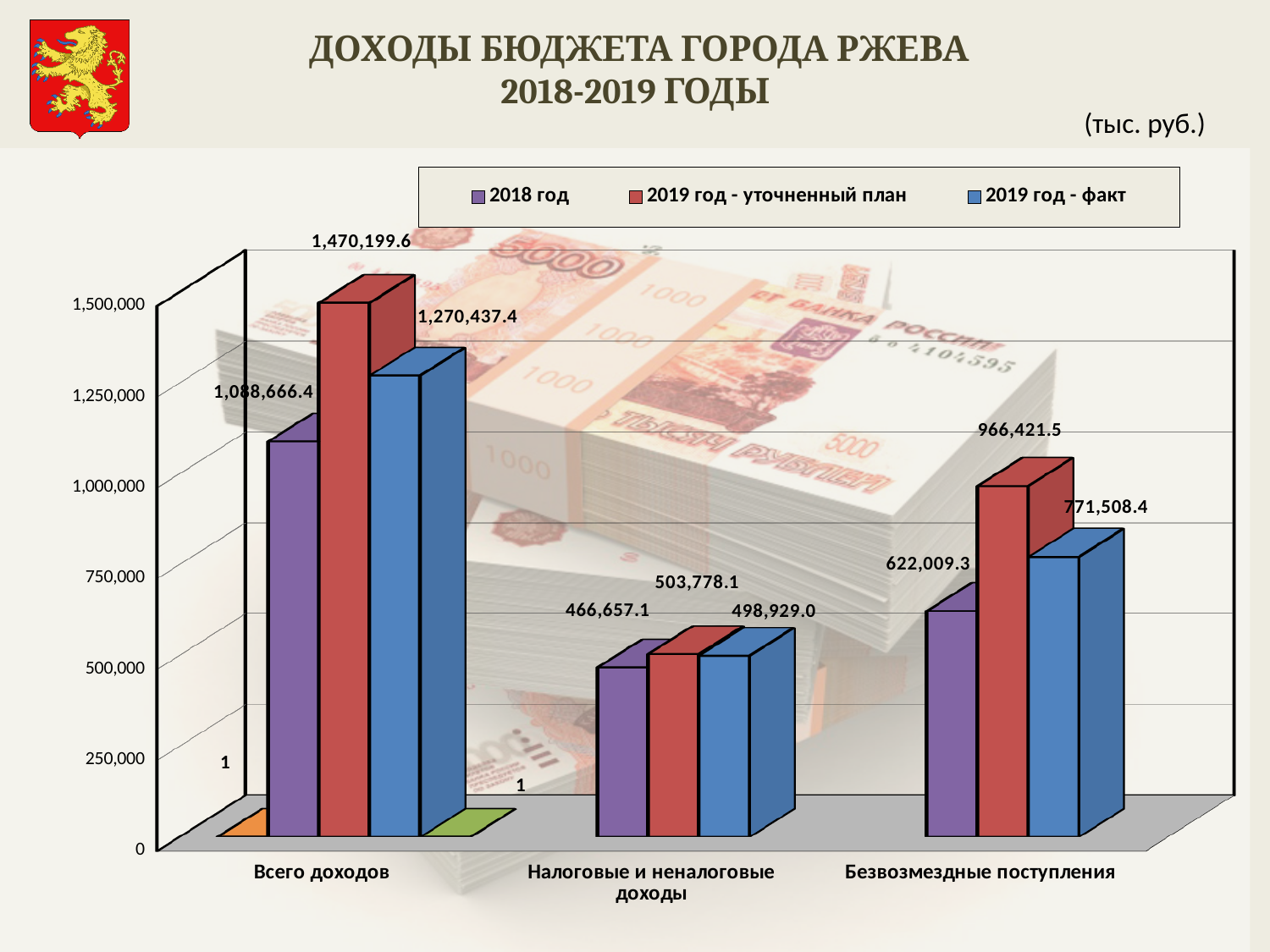
What unit is stated for the values on the slide? тыс. руб. Which is larger in the Безвозмездные поступления category: the 2018 год value or the 2019 год - факт value? 2019 год - факт What is the value for 2018 год in the Всего доходов category? 1,088,666.4 What is the value for 2019 год - уточненный план in the Безвозмездные поступления category? 966,421.5 What kind of chart is shown on the slide? bar chart Which series has the highest value in the Всего доходов category? 2019 год - уточненный план Which category has the lowest value for 2018 год? Налоговые и неналоговые доходы What is the difference between the 2019 год - уточненный план and 2019 год - факт values in the Всего доходов category? 199,762.2 Is the 2019 год - факт value for Всего доходов greater or less than 1,250,000? greater How many series does the legend list? 3 What is the difference between the 2019 год - факт and 2018 год values in the Безвозмездные поступления category? 149,499.1 What is the value for 2019 год - факт in the Налоговые и неналоговые доходы category? 498,929.0